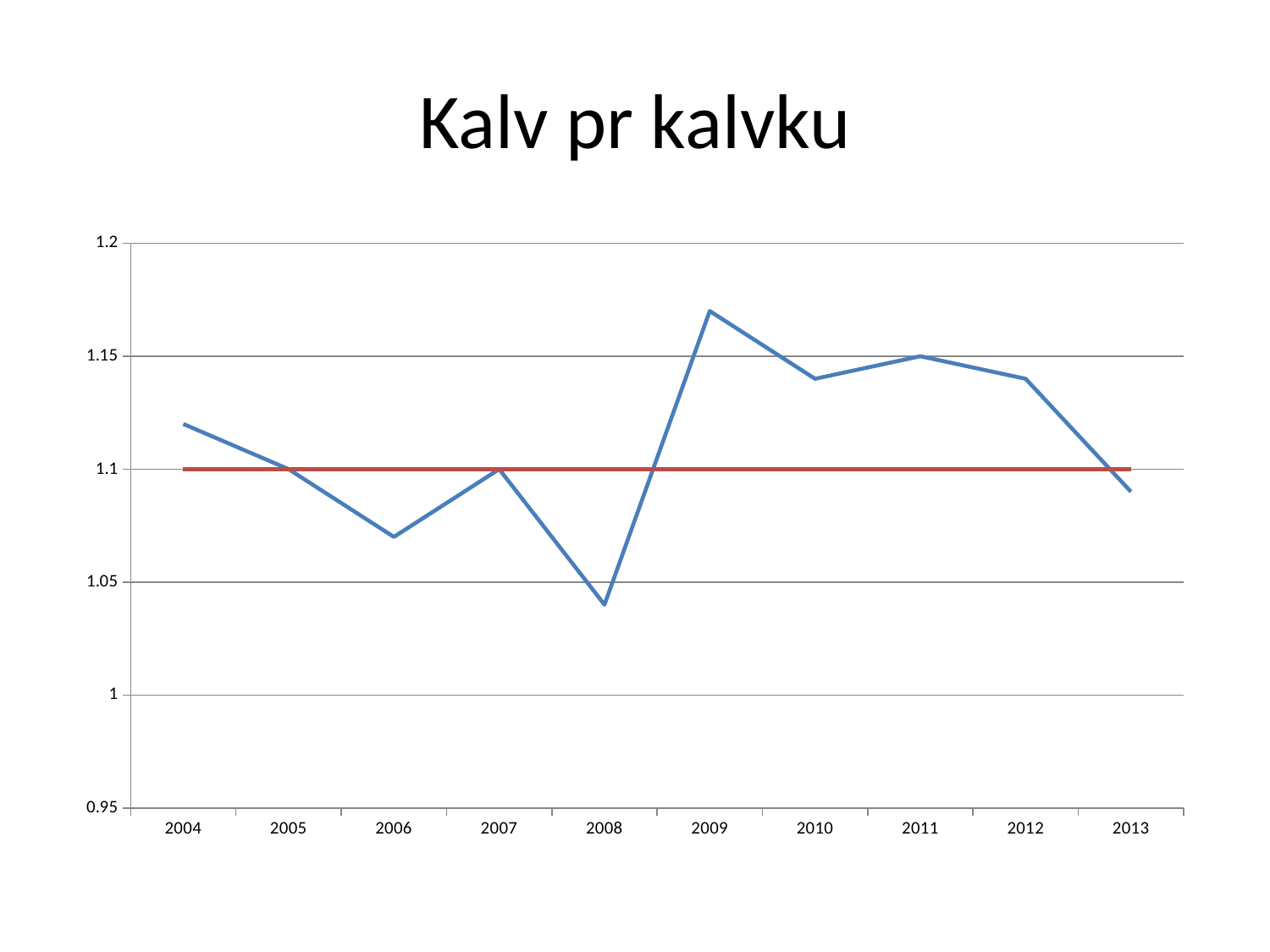
Is the value for 2013 greater or less than 1.1? less Is the value for 2009 greater or less than 1.15? greater Is the value for 2004 greater or less than 1.1? greater What kind of chart is shown on the slide? line chart How many years are plotted along the x axis? 10 What is the title of the chart? Kalv pr kalvku In which year does the blue line reach its highest value? 2009 In which year does the blue line reach its lowest value? 2008 Which year has the larger value, 2006 or 2010? 2010 Does the blue line rise or fall from 2011 to 2013? fall At what constant value is the horizontal red line drawn? 1.1